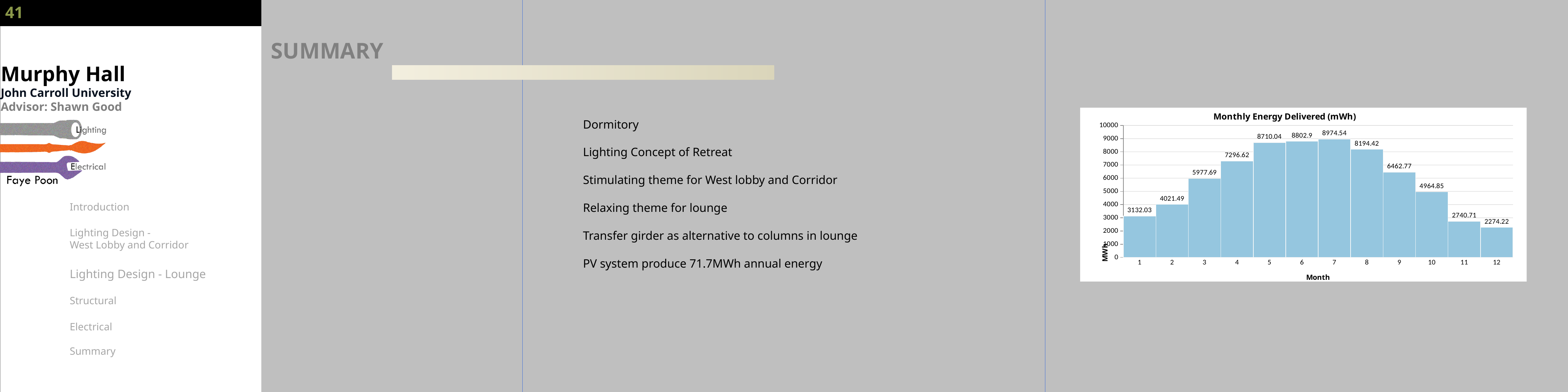
What is the difference in energy delivered between month 7 and month 12? 6700.32 What is the title of the chart on the slide? Monthly Energy Delivered (mWh) What is the energy delivered in month 7? 8974.54 Which month has a larger value, month 3 or month 9? 9 What is the energy delivered in month 1? 3132.03 What is the label on the x axis of the chart? Month What kind of chart is shown on the slide? bar chart Which month has the lowest energy delivered? 12 Is the value for month 4 greater or less than 7000? greater How many months are plotted in the Monthly Energy Delivered chart? 12 What is the energy delivered in month 10? 4964.85 Which month has the highest energy delivered? 7